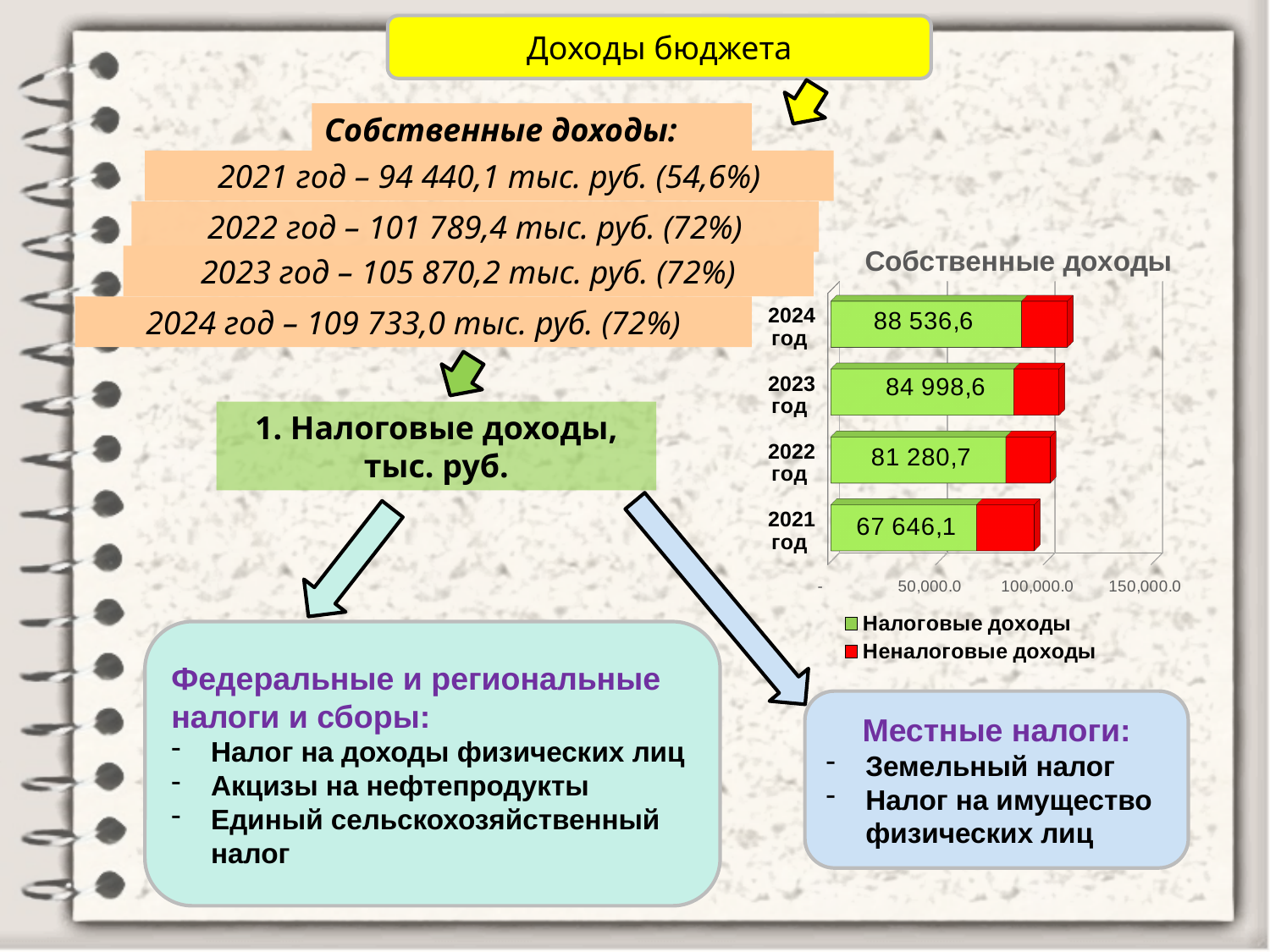
Which year has the lowest value of Налоговые доходы in the chart? 2021 год What is the value of Налоговые доходы for 2022 год in the chart? 81 280,7 Is the value of Налоговые доходы for 2021 год greater or less than 50,000.0? greater What is the value of Налоговые доходы for 2024 год in the chart? 88 536,6 What is the title of the chart on the slide? Собственные доходы Which year has the highest value of Налоговые доходы in the chart? 2024 год What is the difference between Налоговые доходы for 2024 год and 2023 год? 3 538,0 What type of chart is shown on the slide? bar chart Do the values of Налоговые доходы rise or fall from 2021 год to 2024 год? rise How many years (categories) are shown in the chart? 4 What is the value of Налоговые доходы for 2021 год in the chart? 67 646,1 How many series does the chart legend list? 2